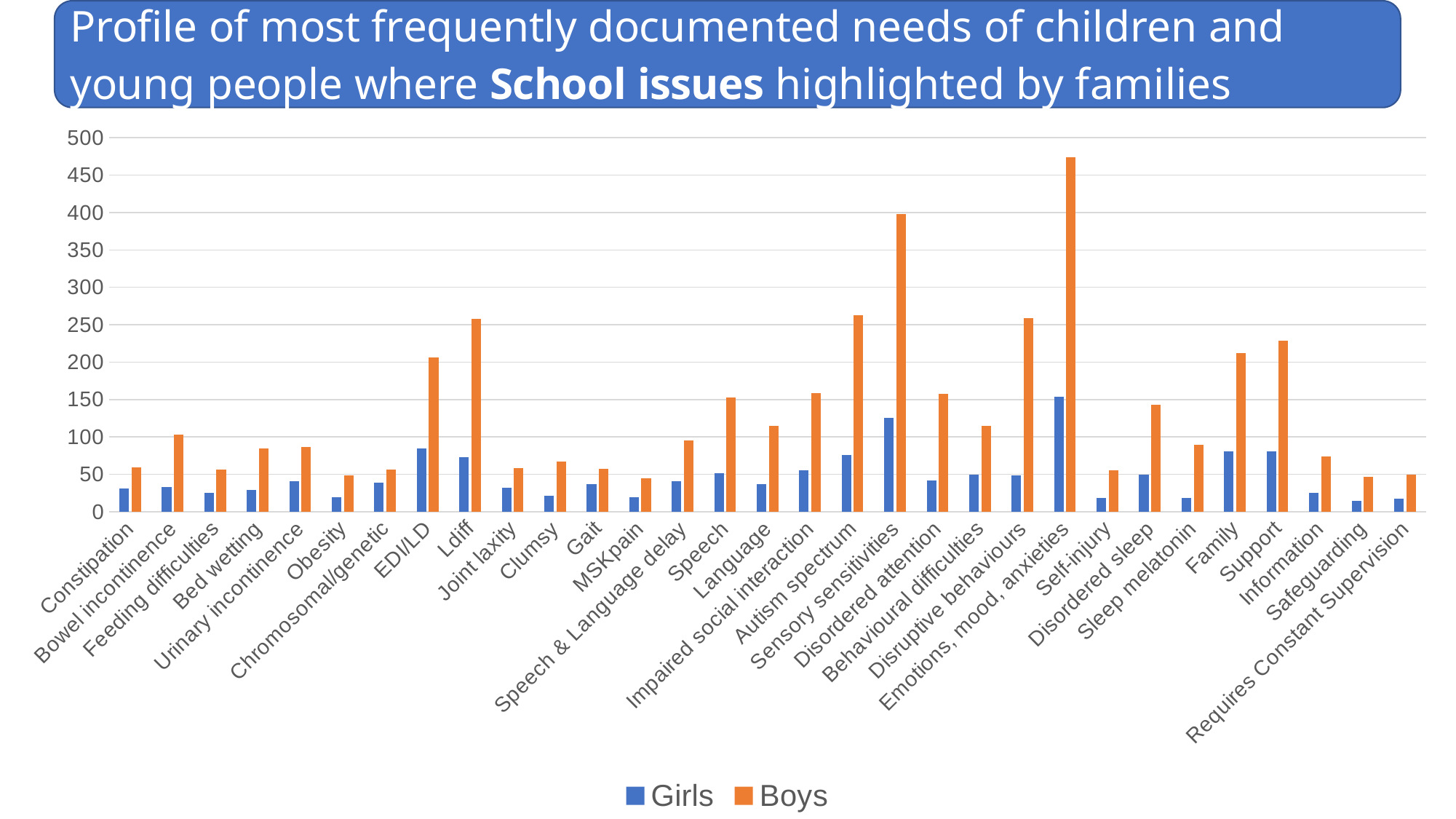
What are the two series named in the legend? Girls and Boys How many categories are shown along the x axis? 31 Which category has the highest value for Boys? Emotions, mood, anxieties Which category has the highest value for Girls? Emotions, mood, anxieties Is the Girls value for Constipation greater or less than 50? less Which is larger for Boys: Ldiff or EDI/LD? Ldiff Is the Boys value for Autism spectrum greater or less than 200? greater What kind of chart is shown on the slide? Bar chart How many series does the legend list? 2 Is the Girls value for Sensory sensitivities greater or less than 100? greater Which is larger for Boys: Bowel incontinence or Bed wetting? Bowel incontinence